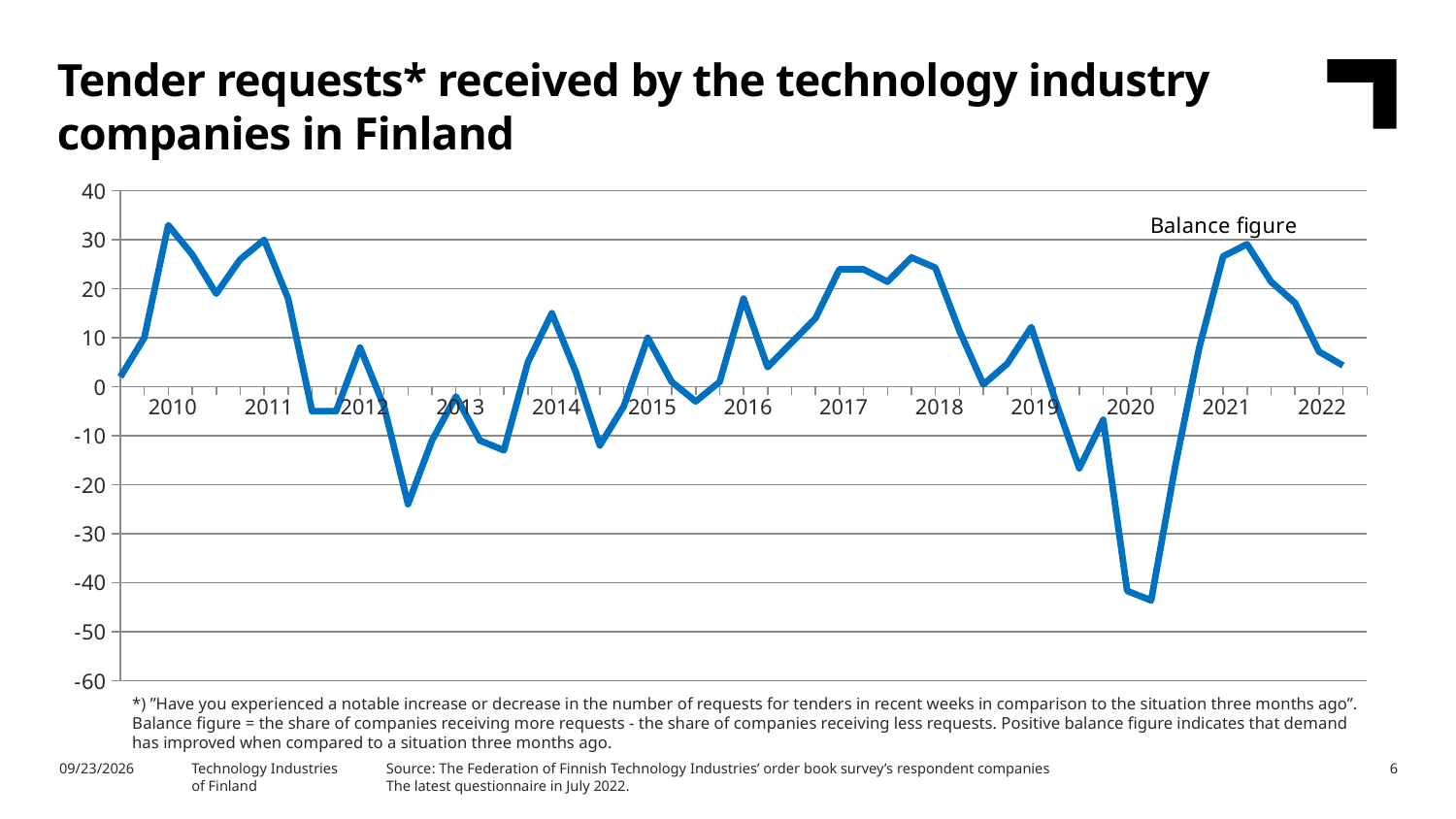
Is the last plotted value in 2022 greater or less than 0? greater Is the peak value of the line in 2021 greater or less than 20? greater Is the lowest value of the line, reached in 2020, greater or less than -40? less In which year does the line reach its lowest value? 2020 Which is higher: the lowest point of the line in 2020 or the peak of the line in 2021? the peak in 2021 Does the balance figure rise or fall from its 2021 peak to the end of 2022? fall What is the title of the chart on the slide? Tender requests* received by the technology industry companies in Finland What kind of chart is shown on the slide? line chart What label is shown for the plotted series in the chart? Balance figure How many year labels are shown on the x axis? 13